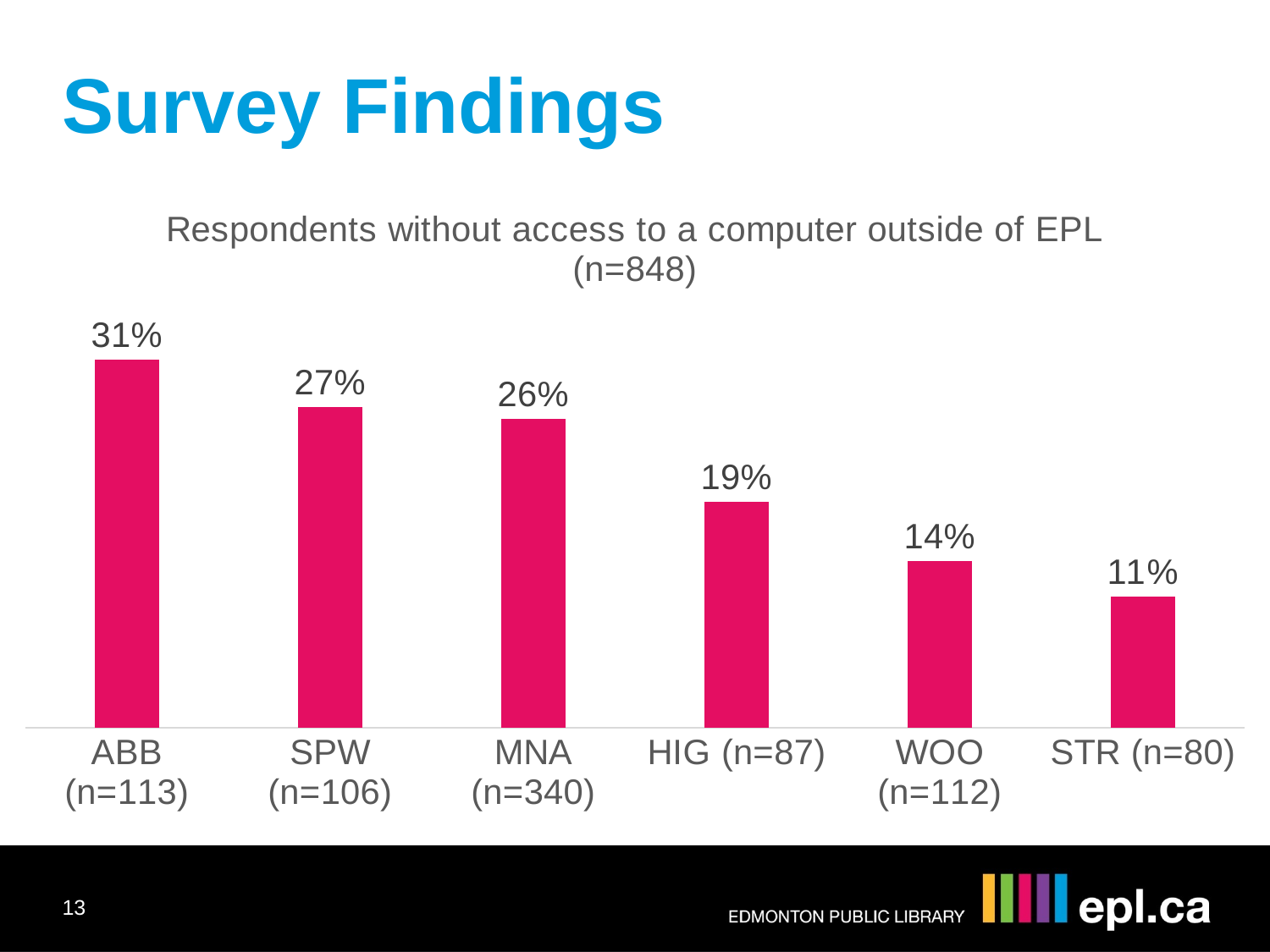
Do the values rise or fall from left to right across the chart? Fall What is the difference between the values for SPW (n=106) and HIG (n=87)? 8% What is the total number of respondents (n) given in the chart title? 848 Which has a higher value, HIG (n=87) or WOO (n=112)? HIG (n=87) Which branch has the lowest percentage of respondents without access to a computer outside of EPL? STR (n=80) What is the difference between the values for ABB (n=113) and STR (n=80)? 20% What is the value shown for WOO (n=112)? 14% What is the value shown for MNA (n=340)? 26% Which branch has the highest percentage of respondents without access to a computer outside of EPL? ABB (n=113) What percentage of respondents at ABB (n=113) lack access to a computer outside of EPL? 31% What kind of chart is shown on the slide? Bar chart How many branches are shown in the chart? 6